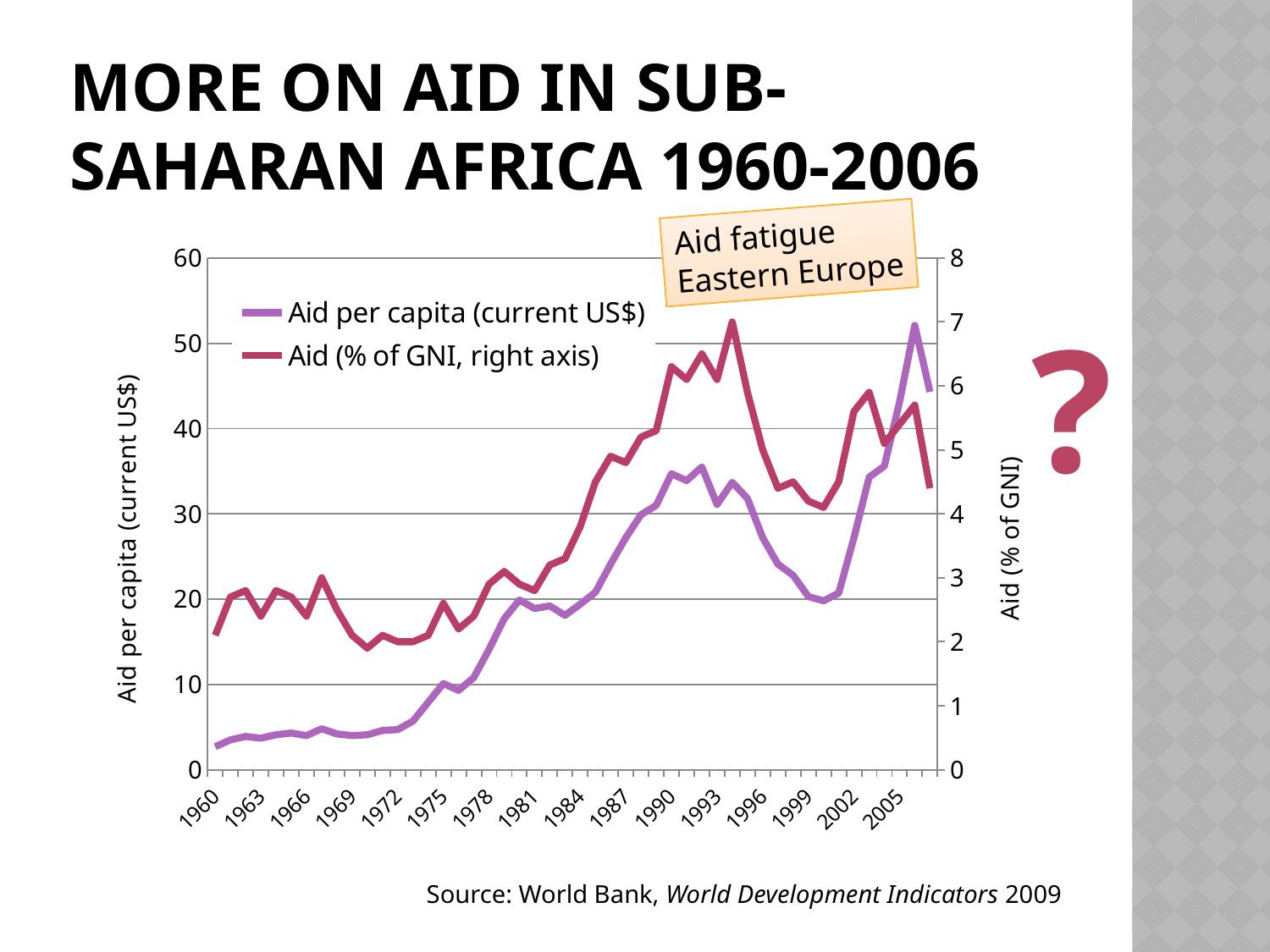
How many series does the chart's legend list? 2 Is Aid per capita (current US$) higher in 1960 or in 1990? 1990 Does Aid per capita (current US$) rise or fall between 1990 and 1999? Fall Is the value of Aid per capita (current US$) in 1960 greater or less than 10? less Is the value of Aid per capita (current US$) in 1975 greater or less than 20? less What kind of chart is shown on the slide? Line chart Does Aid per capita (current US$) rise or fall between 1960 and 1990? Rise Which series is plotted against the right axis? Aid (% of GNI) What is the label of the left vertical axis? Aid per capita (current US$) Is the value of Aid (% of GNI) in 1960 greater or less than 3? less